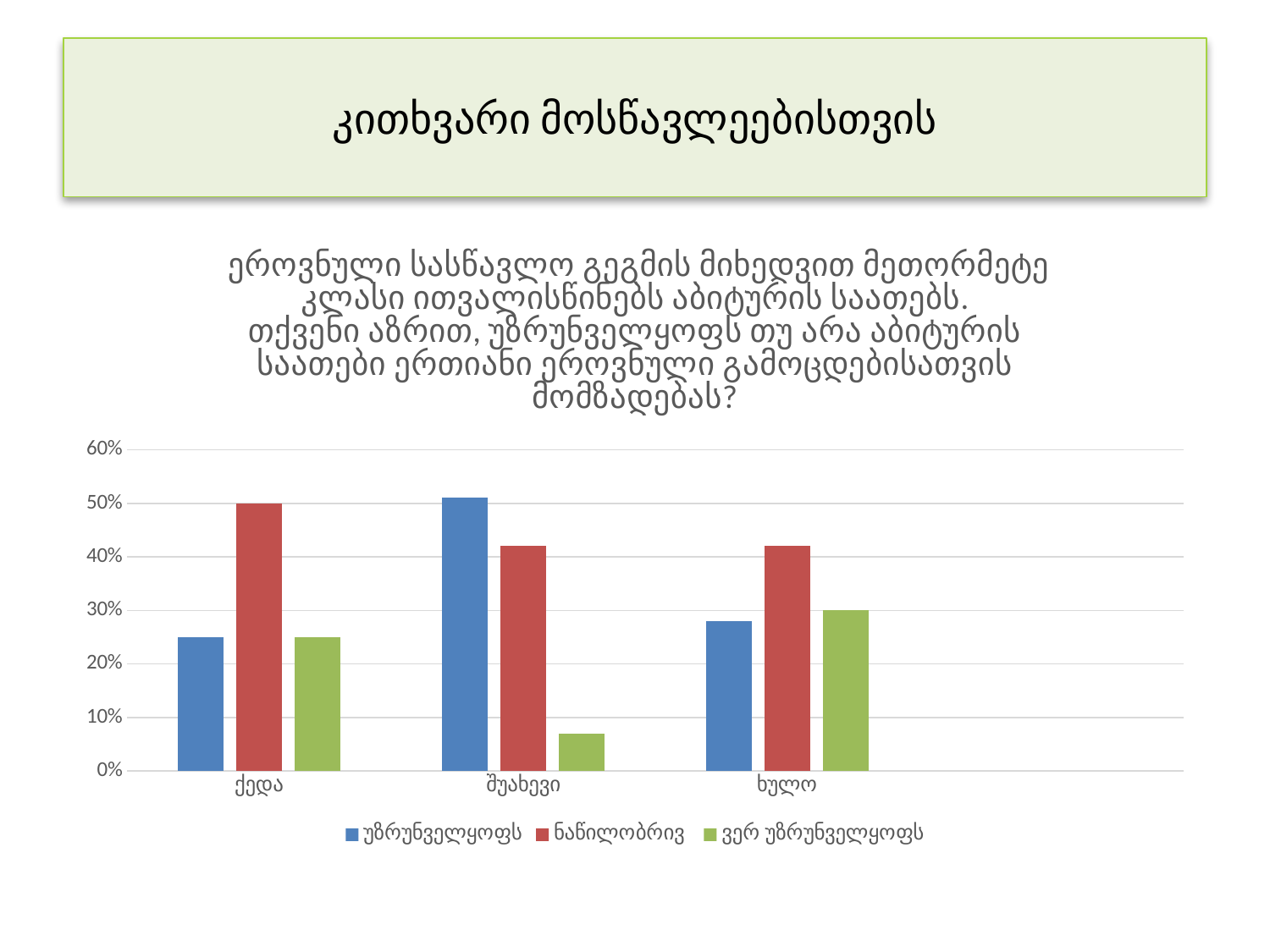
Is the value of ვერ უზრუნველყოფს for შუახევი greater or less than 10%? less For ქედა, which is larger: უზრუნველყოფს or ნაწილობრივ? ნაწილობრივ What type of chart is shown on the slide? bar chart How many categories are shown on the x axis of the chart? 3 Which series has the highest value for შუახევი? უზრუნველყოფს How many series does the chart's legend list? 3 Which series has the lowest value for შუახევი? ვერ უზრუნველყოფს For which category is the უზრუნველყოფს series highest? შუახევი Is the value of უზრუნველყოფს for შუახევი greater or less than 40%? greater Is the value of ნაწილობრივ for ხულო greater or less than 40%? greater What is the value of ნაწილობრივ for ქედა? 50% Which series is shown in green in the chart's legend? ვერ უზრუნველყოფს